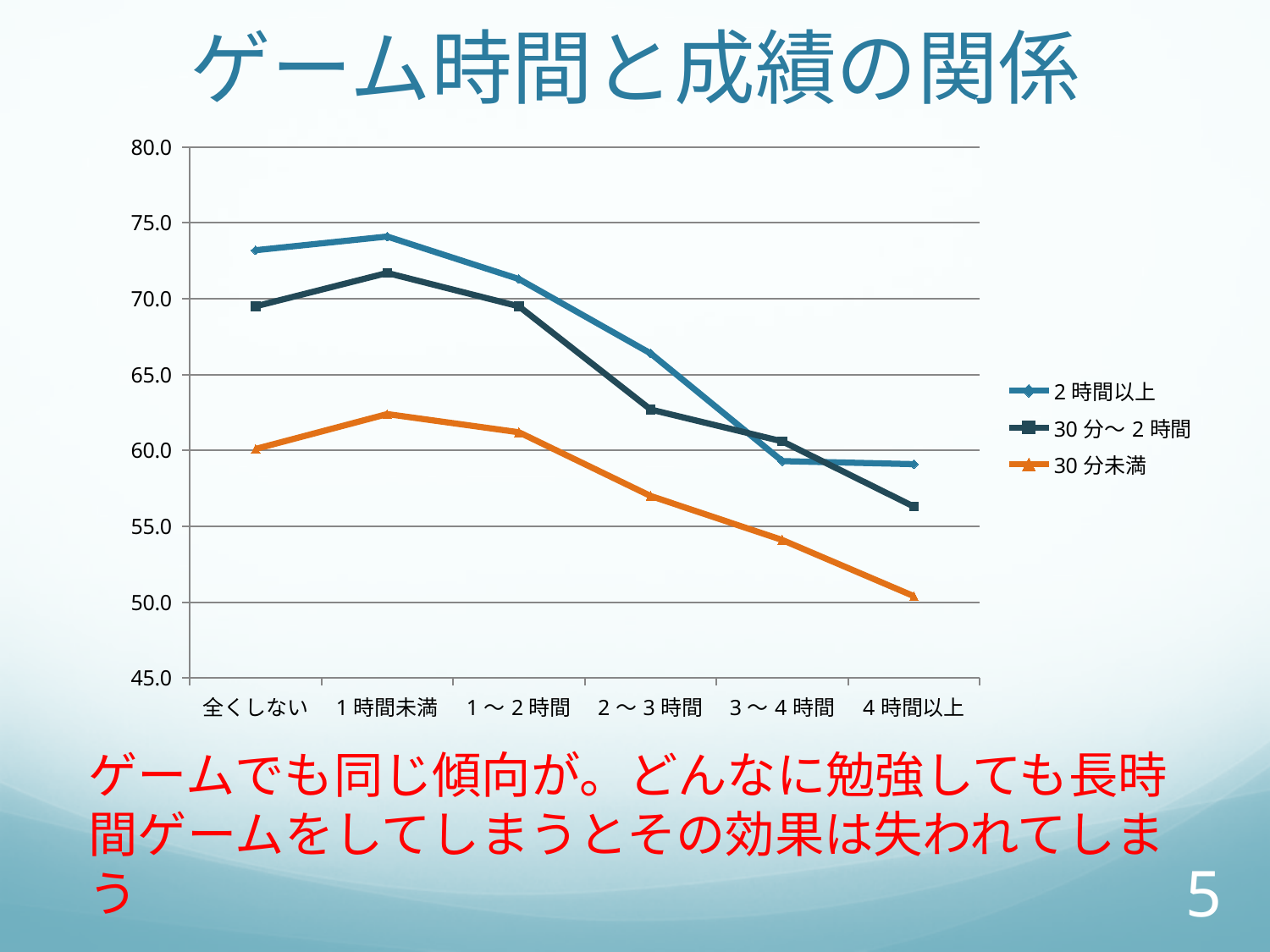
Which series is drawn in orange with triangle markers? 30分未満 For the 30分～2時間 series, which category has the lowest value? 4時間以上 For the 30分未満 series, which category has the highest value? 1時間未満 What kind of chart is shown on the slide? line chart At 2～3時間, which series has the larger value, 2時間以上 or 30分～2時間? 2時間以上 For the 30分未満 series, which category has the lowest value? 4時間以上 How many categories are shown on the x axis? 6 How many series does the legend list? 3 What is the title of the chart? ゲーム時間と成績の関係 Is the value for 2時間以上 at 1時間未満 greater or less than 70.0? greater Is the value for 30分未満 at 4時間以上 greater or less than 55.0? less Do the values for the 30分未満 series rise or fall from 1時間未満 to 4時間以上? fall